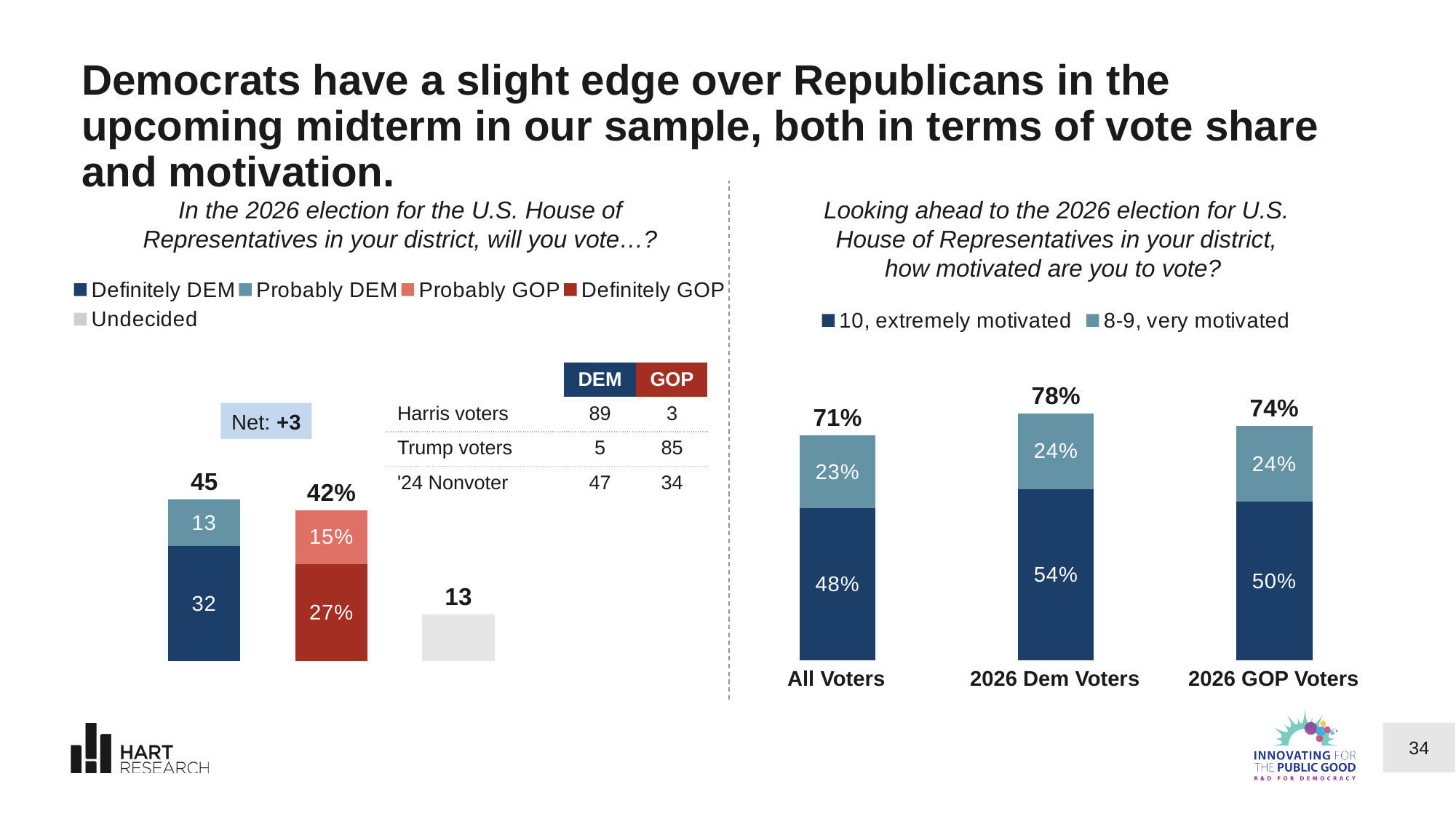
In the right-hand chart on motivation to vote, what share of 2026 GOP Voters are '8-9, very motivated'? 24% In the left-hand chart on the 2026 House vote, what is the 'Definitely DEM' value? 32 In the right-hand chart on motivation to vote, which voter group has the highest total motivated percentage? 2026 Dem Voters In the right-hand chart on motivation to vote, which voter group has the lowest total motivated percentage? All Voters In the left-hand chart on the 2026 House vote, what is the total of the GOP stacked bar? 42% In the right-hand chart on motivation to vote, how many voter groups are shown on the x axis? 3 In the right-hand chart on motivation to vote, what is the total percentage shown above the bar for 2026 Dem Voters? 78% In the right-hand chart on motivation to vote, what share of All Voters are '10, extremely motivated'? 48% In the right-hand chart on motivation to vote, how many series does the legend list? 2 What kind of chart is the right-hand chart on motivation to vote? Stacked bar chart In the right-hand chart on motivation to vote, what is the difference between the total for 2026 Dem Voters and the total for 2026 GOP Voters? 4 percentage points In the left-hand chart on the 2026 House vote, how many entries does the legend list? 5